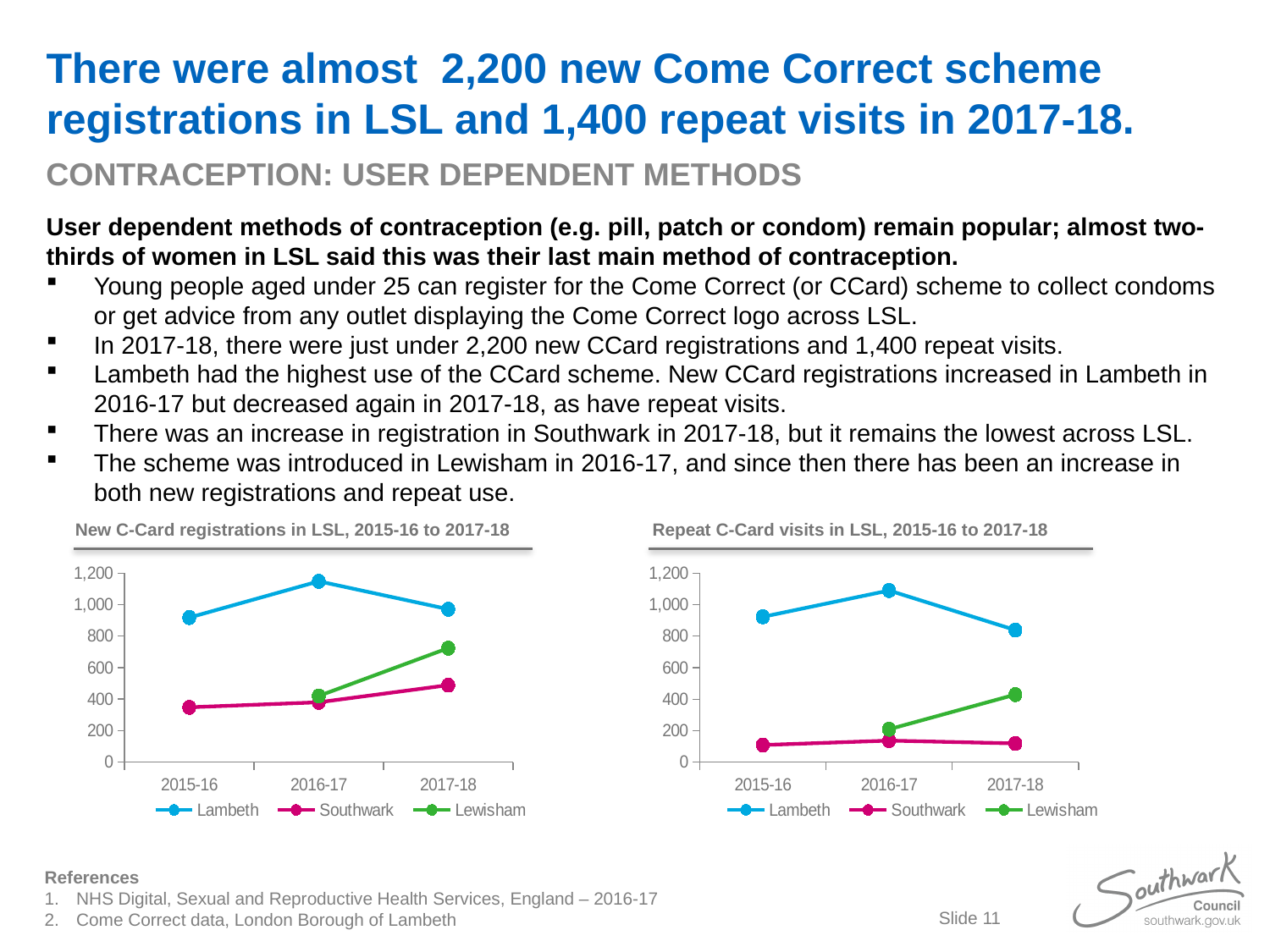
In the 'New C-Card registrations in LSL, 2015-16 to 2017-18' chart, which borough has the highest value in 2017-18? Lambeth In the 'New C-Card registrations in LSL, 2015-16 to 2017-18' chart, is the value for Lambeth in 2016-17 greater or less than 1,000? greater In the 'New C-Card registrations in LSL, 2015-16 to 2017-18' chart, is the value for Lewisham in 2017-18 greater or less than 600? greater In the 'Repeat C-Card visits in LSL, 2015-16 to 2017-18' chart, is the value for Southwark in 2015-16 greater or less than 200? less How many series does the legend of the 'Repeat C-Card visits in LSL, 2015-16 to 2017-18' chart list? 3 What kind of chart is the 'New C-Card registrations in LSL, 2015-16 to 2017-18' chart? line chart In the 'New C-Card registrations in LSL, 2015-16 to 2017-18' chart, which is larger in 2017-18: Lewisham or Southwark? Lewisham How many time periods are shown on the x axis of the 'New C-Card registrations in LSL, 2015-16 to 2017-18' chart? 3 In the 'Repeat C-Card visits in LSL, 2015-16 to 2017-18' chart, does the Lewisham line rise or fall from 2016-17 to 2017-18? rise In the 'Repeat C-Card visits in LSL, 2015-16 to 2017-18' chart, which borough has the lowest value in 2017-18? Southwark In the 'Repeat C-Card visits in LSL, 2015-16 to 2017-18' chart, what colour is the Lambeth line? blue